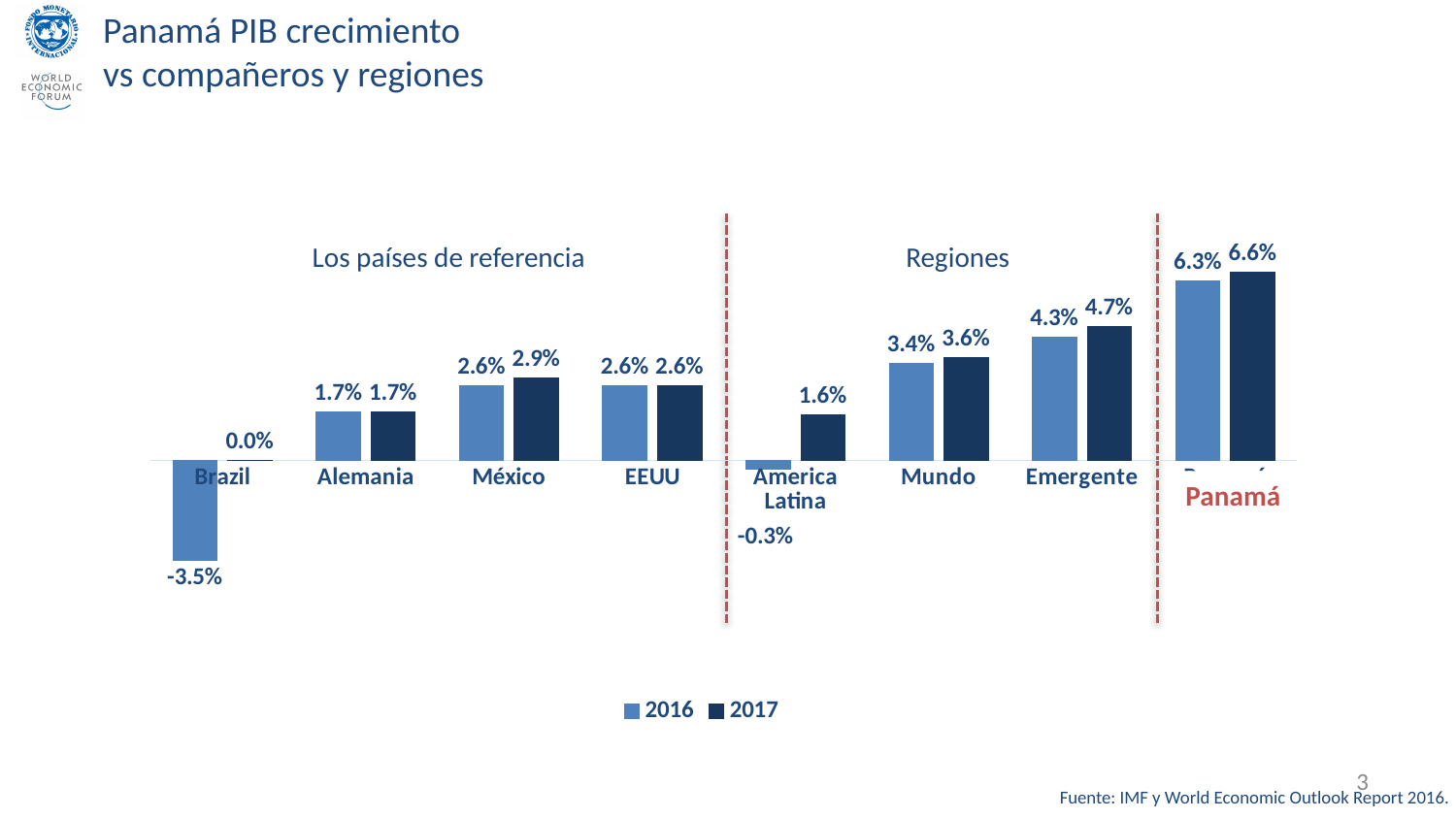
How many series does the legend list? 2 What is the difference between the 2017 and 2016 values for Panamá? 0.3% Which category has the highest 2017 value? Panamá What is the 2017 value for Emergente? 4.7% What is the 2016 value for America Latina? -0.3% What kind of chart is shown on the slide? bar chart Which category has the lowest 2016 value? Brazil What is the 2016 value for Brazil? -3.5% What is the 2017 value for México? 2.9% How many categories are shown on the x axis of the chart? 8 What are the two group labels shown above the bars, left and right of the first dashed line? Los países de referencia; Regiones Which is larger, the 2016 value for Mundo or the 2016 value for Emergente? Emergente